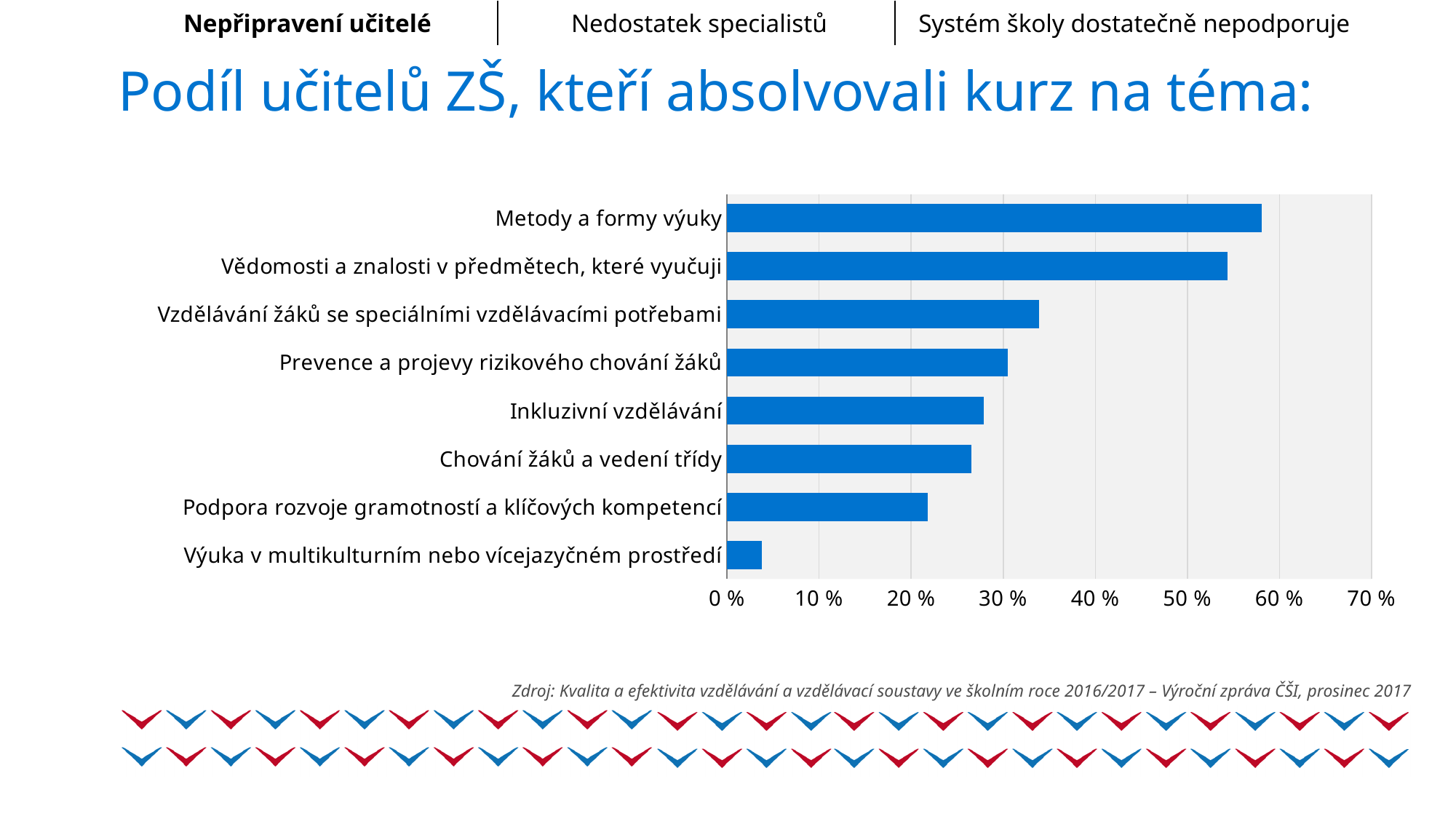
Which is larger: the value for Metody a formy výuky or for Vědomosti a znalosti v předmětech, které vyučuji? Metody a formy výuky What is the title of the chart on the slide? Podíl učitelů ZŠ, kteří absolvovali kurz na téma: How many categories are shown in the chart? 8 Which category has the highest share of teachers who completed a course? Metody a formy výuky What type of chart is shown on the slide? bar chart Is the value for Podpora rozvoje gramotností a klíčových kompetencí greater or less than 20 %? greater Is the value for Inkluzivní vzdělávání greater or less than 30 %? less Is the value for Metody a formy výuky greater or less than 50 %? greater Which category has the lowest share of teachers who completed a course? Výuka v multikulturním nebo vícejazyčném prostředí Do the bar values rise or fall going from the top category to the bottom category? fall